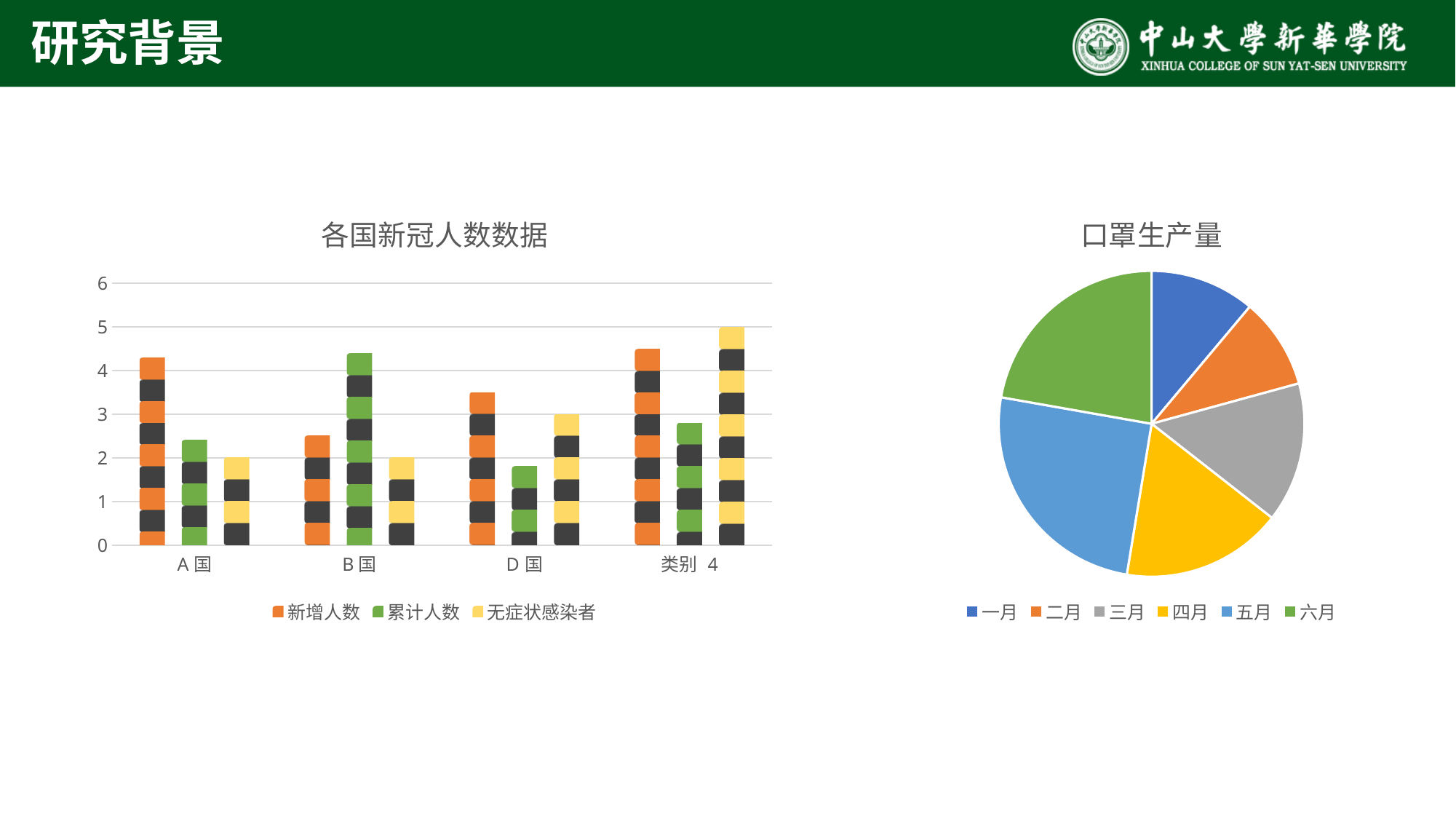
In the chart titled 各国新冠人数数据, which series has the highest value for B 国? 累计人数 In the chart titled 各国新冠人数数据, is the value of 累计人数 for B 国 greater or less than 4? greater In the chart titled 各国新冠人数数据, how many categories are shown on the x axis? 4 In the chart titled 各国新冠人数数据, is the value of 新增人数 for A 国 greater or less than 4? greater In the chart titled 各国新冠人数数据, is the value of 累计人数 for D 国 greater or less than 2? less What type of chart is the chart titled 各国新冠人数数据? bar chart In the chart titled 口罩生产量, how many slices does the pie have? 6 In the chart titled 口罩生产量, which slice is larger: 五月 or 一月? 五月 In the chart titled 各国新冠人数数据, how many series does the legend list? 3 In the chart titled 各国新冠人数数据, for D 国, which is larger: 新增人数 or 累计人数? 新增人数 In the chart titled 各国新冠人数数据, which series has the highest value for 类别 4? 无症状感染者 What type of chart is the chart titled 口罩生产量? pie chart